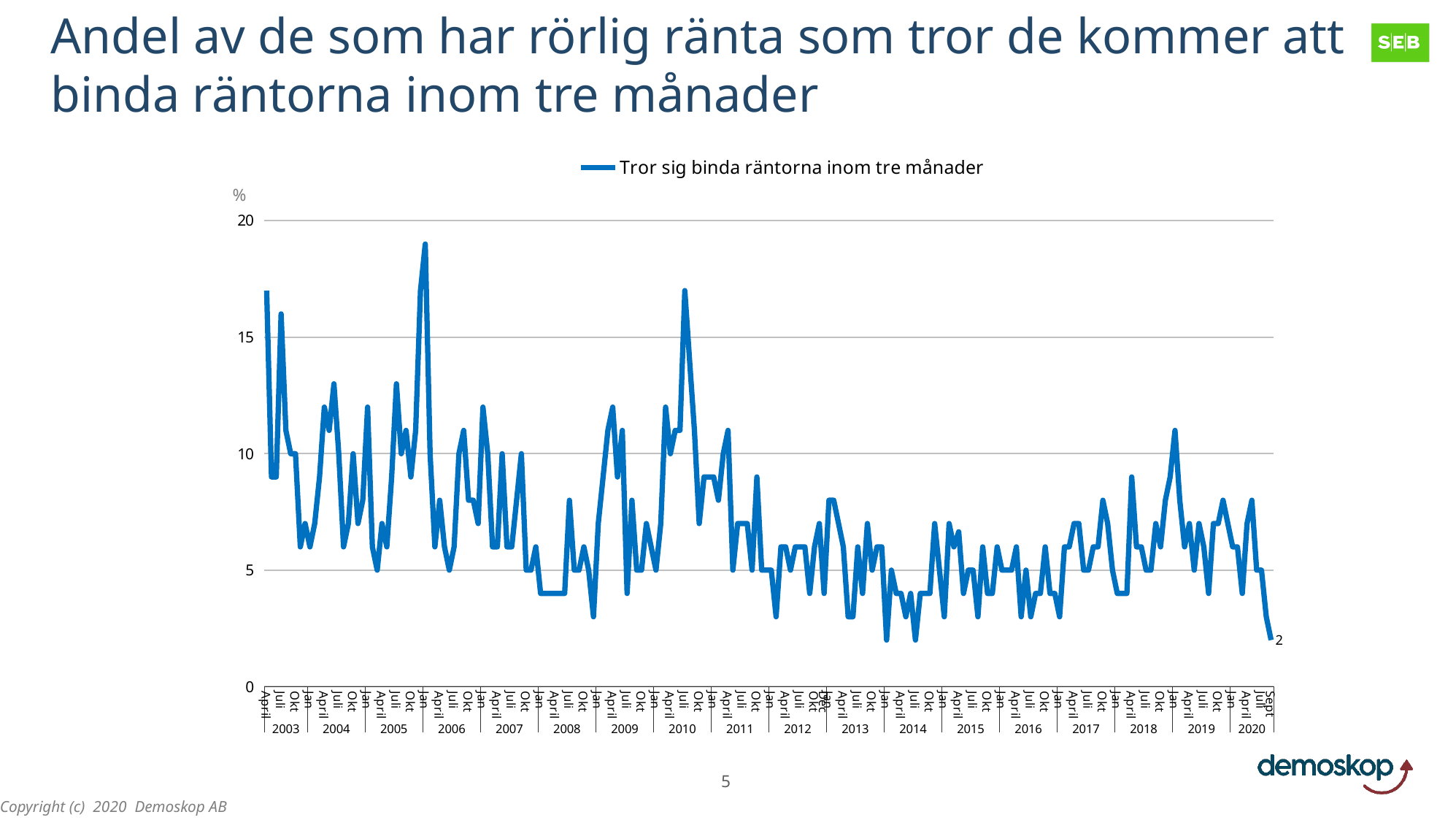
What is the highest value shown on the y axis? 20 What kind of chart is shown on the slide? line chart What is the legend entry for the plotted series? Tror sig binda räntorna inom tre månader Is the highest point of the line greater or less than 15? greater How many series does the legend list? 1 How many years are labelled along the x axis? 18 Overall, do the values rise or fall from 2003 to 2020? fall Which is larger, the value at the start of the series in April 2003 or the value at the end in Sept 2020? April 2003 In which year does the line reach its highest point? 2006 What is the value of the last data point (Sept 2020), as printed on the chart? 2 Is the value at the first point of the series (April 2003) greater or less than 15? greater